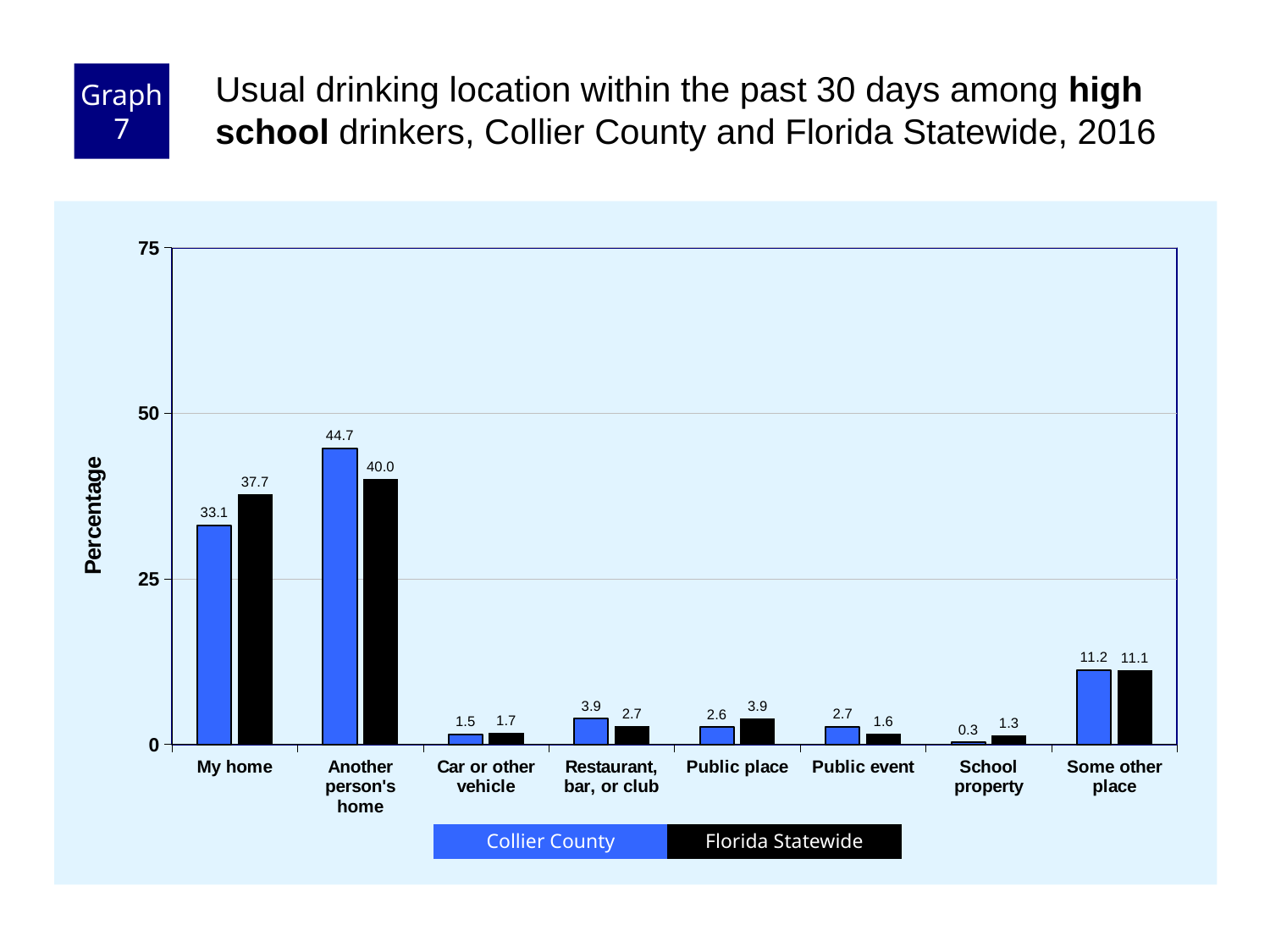
What is the label on the y axis? Percentage Is the Collier County value for "My home" greater or less than 25? greater Which category has the highest Collier County value? Another person's home What is the difference between the Collier County and Florida Statewide values for "Another person's home"? 4.7 What kind of chart is shown on the slide? Bar chart How many categories are shown on the x axis? 8 What is the Collier County value for "Another person's home"? 44.7 What is the Collier County value for "School property"? 0.3 How many series does the legend list? 2 Which category has the lowest Florida Statewide value? School property Which is larger for "Public place": Collier County or Florida Statewide? Florida Statewide What is the Florida Statewide value for "My home"? 37.7